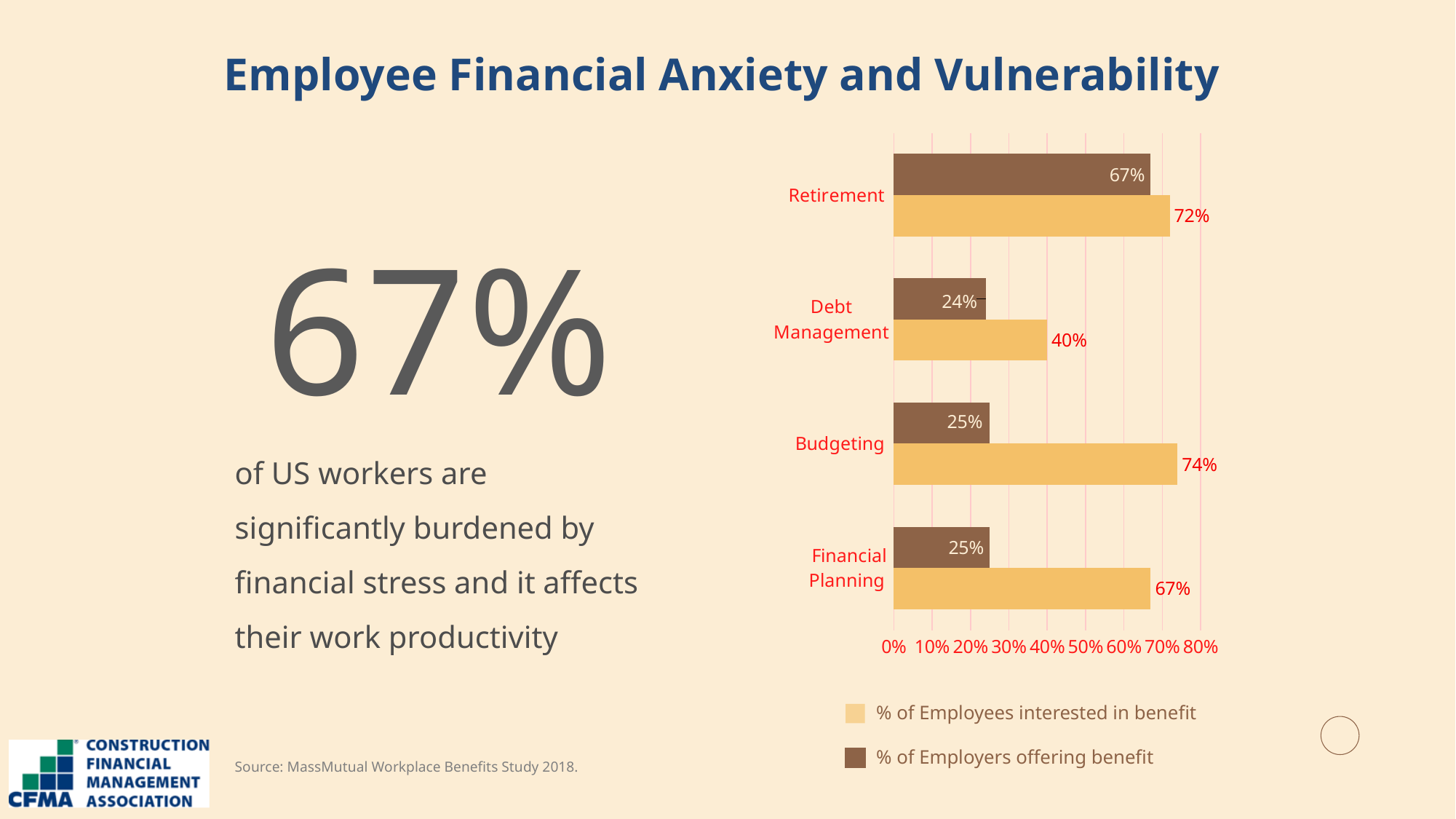
How many series does the chart legend list? 2 What percentage of employers offer the Financial Planning benefit? 25% What percentage of employees are interested in the Budgeting benefit? 74% How many benefit categories are shown in the chart? 4 Which series is shown in the darker brown colour in the chart? % of Employers offering benefit What is the difference between the percentage of employees interested in Budgeting and the percentage of employers offering it? 49% Which category has the lowest percentage of employers offering the benefit? Debt Management What type of chart is shown on the slide? Bar chart What percentage of employees are interested in the Retirement benefit? 72% Which category has the highest percentage of employees interested in the benefit? Budgeting What percentage of employers offer the Debt Management benefit? 24% Which is larger: the percentage of employers offering the Retirement benefit or the percentage of employers offering the Budgeting benefit? Retirement